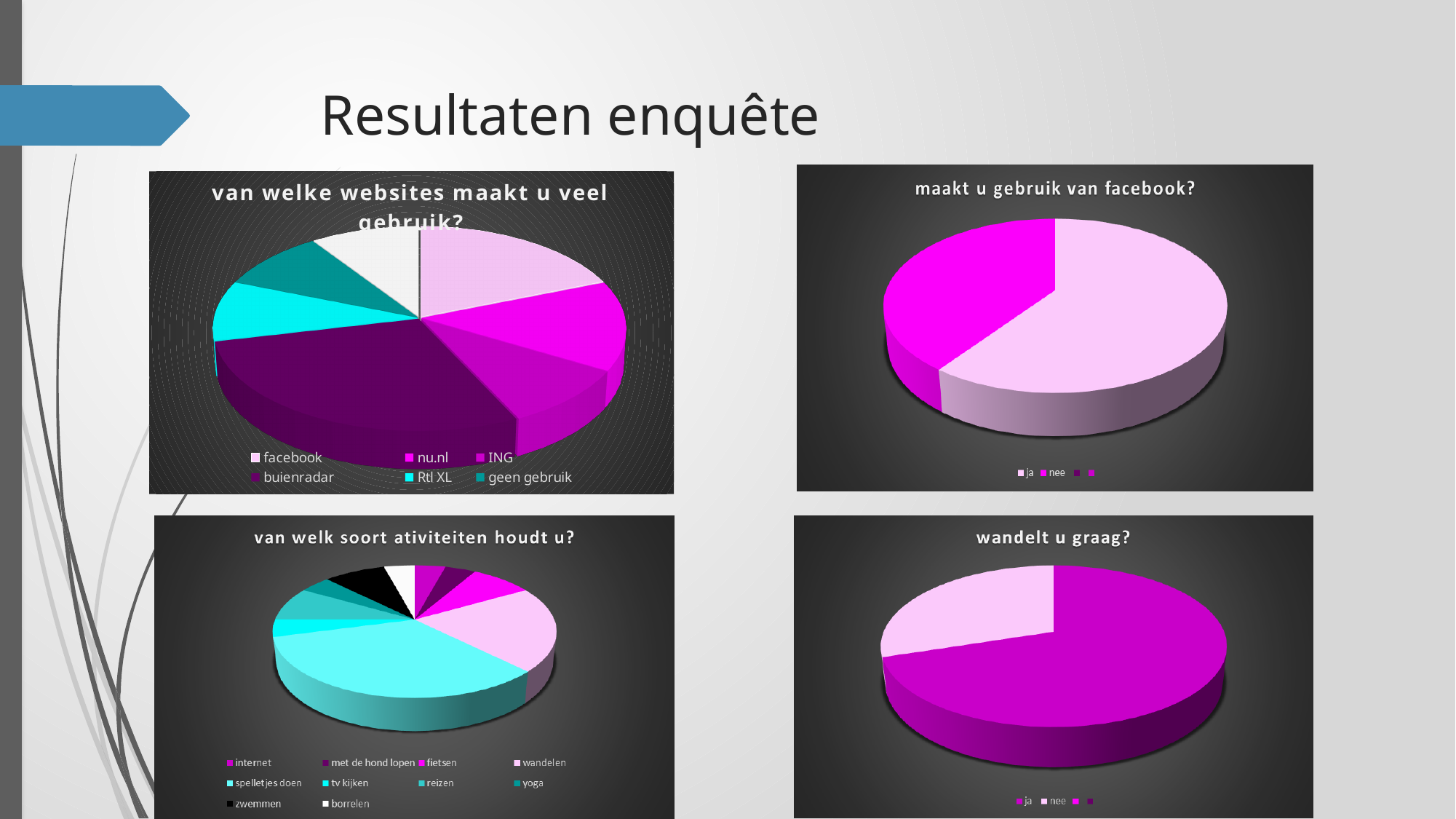
In the chart titled "van welk soort ativiteiten houdt u?", which activity has the largest slice? spelletjes doen What kind of chart is the chart titled "van welke websites maakt u veel gebruik?"? pie chart How many pie charts are shown on the slide? 4 In the chart titled "maakt u gebruik van facebook?", which answer has the larger slice, ja or nee? ja In the chart titled "van welke websites maakt u veel gebruik?", which website has the largest slice? buienradar How many activities does the legend of the chart titled "van welk soort ativiteiten houdt u?" list? 10 In the chart titled "wandelt u graag?", which answer has the larger slice, ja or nee? nee How many entries does the legend of the chart titled "van welke websites maakt u veel gebruik?" list? 6 In the chart titled "van welk soort ativiteiten houdt u?", which slice is larger, tv kijken or zwemmen? zwemmen What kind of chart is the chart titled "maakt u gebruik van facebook?"? pie chart What is the title of the chart in the bottom-right of the slide? wandelt u graag?